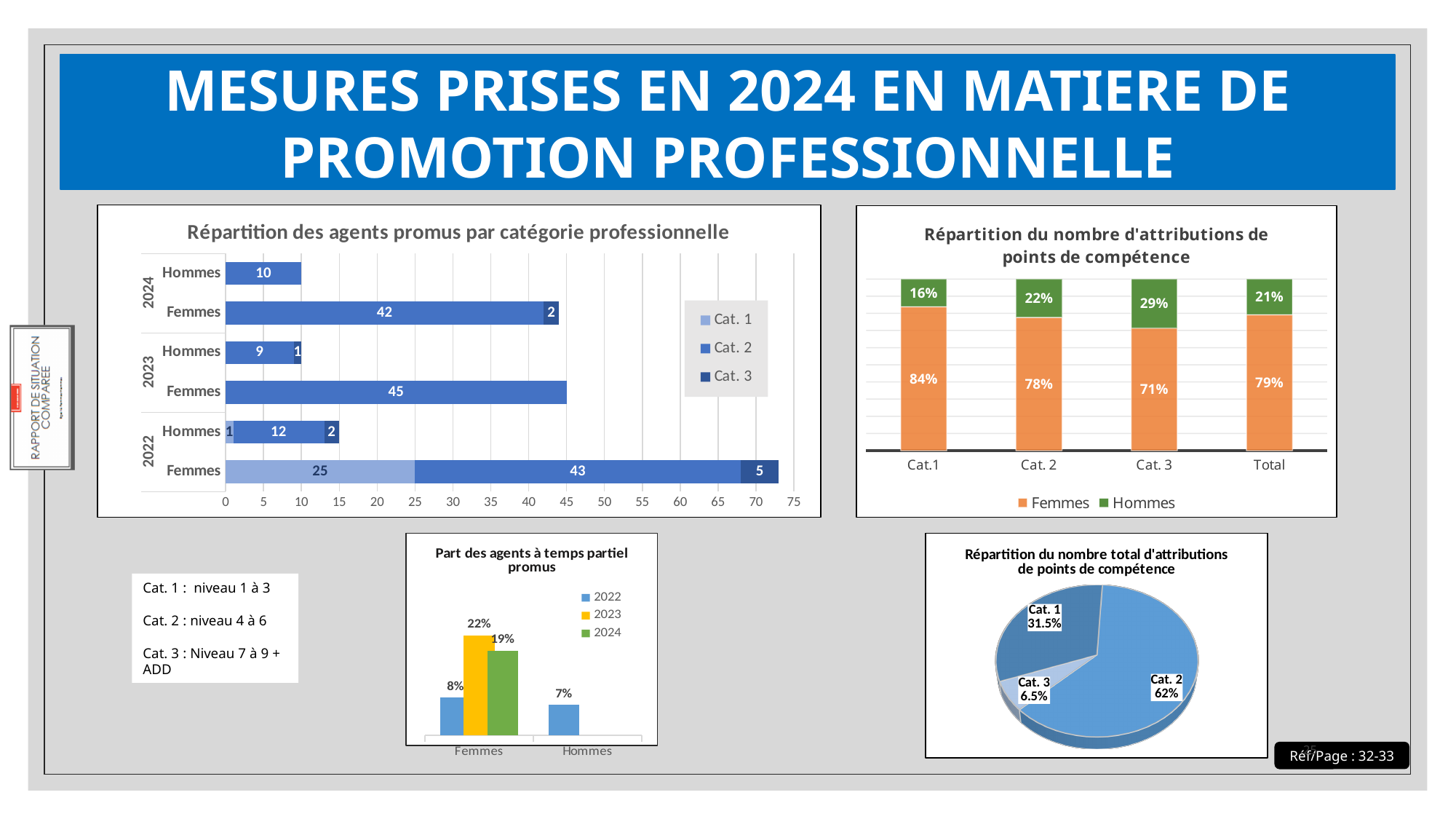
In the chart 'Répartition des agents promus par catégorie professionnelle', what is the Cat. 2 value for Hommes in 2024? 10 In the chart 'Part des agents à temps partiel promus', which is larger for Femmes: the 2022 value or the 2024 value? 2024 In the chart 'Répartition des agents promus par catégorie professionnelle', what is the difference between the Cat. 2 values for Femmes in 2024 and Hommes in 2024? 32 In the chart 'Répartition des agents promus par catégorie professionnelle', what is the Cat. 2 value for Femmes in 2023? 45 In the chart 'Répartition du nombre d'attributions de points de compétence', what is the Hommes share for Total? 21% In the chart 'Répartition du nombre d'attributions de points de compétence', what is the Femmes share for Cat. 3? 71% What kind of chart is 'Répartition du nombre total d'attributions de points de compétence'? Pie chart In the chart 'Répartition des agents promus par catégorie professionnelle', how many series does the legend list? 3 In the chart 'Répartition du nombre d'attributions de points de compétence', which category has the highest Hommes share? Cat. 3 In the chart 'Part des agents à temps partiel promus', what is the 2023 value for Femmes? 22% In the pie chart 'Répartition du nombre total d'attributions de points de compétence', what share does Cat. 2 have? 62% In the chart 'Répartition des agents promus par catégorie professionnelle', what is the total of the stacked bar for Femmes in 2022? 73